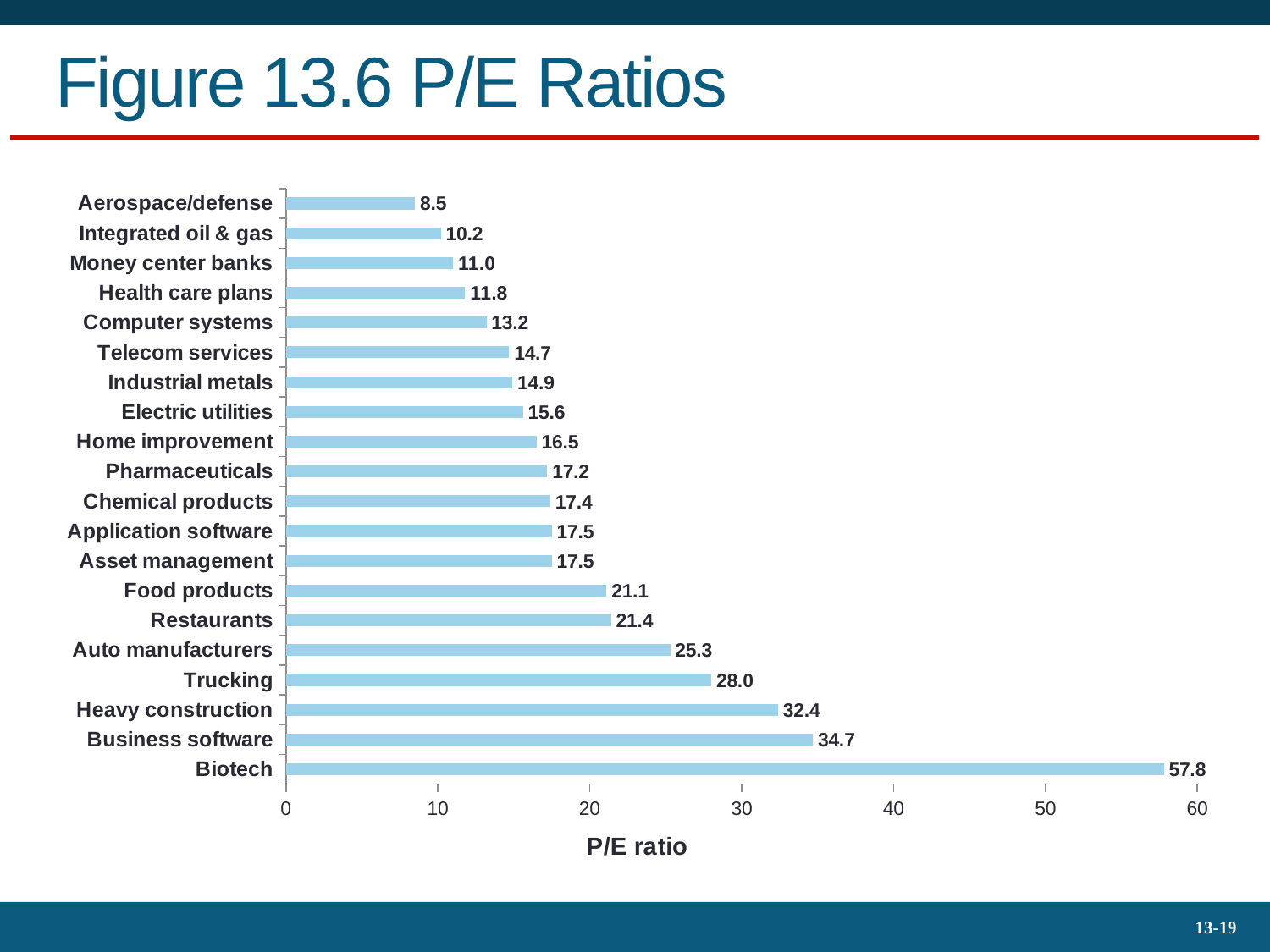
Which industry has the highest P/E ratio? Biotech Which has a higher P/E ratio, Auto manufacturers or Restaurants? Auto manufacturers What type of chart is shown on the slide? Bar chart What is the P/E ratio for Trucking? 28.0 What is the label of the horizontal axis? P/E ratio How many industries are shown in the chart? 20 Is the P/E ratio for Heavy construction greater or less than 30? greater What is the difference between the P/E ratios of Biotech and Aerospace/defense? 49.3 What is the difference between the P/E ratios of Business software and Heavy construction? 2.3 What is the P/E ratio for Biotech? 57.8 Which industry has the lowest P/E ratio? Aerospace/defense What is the P/E ratio for Health care plans? 11.8